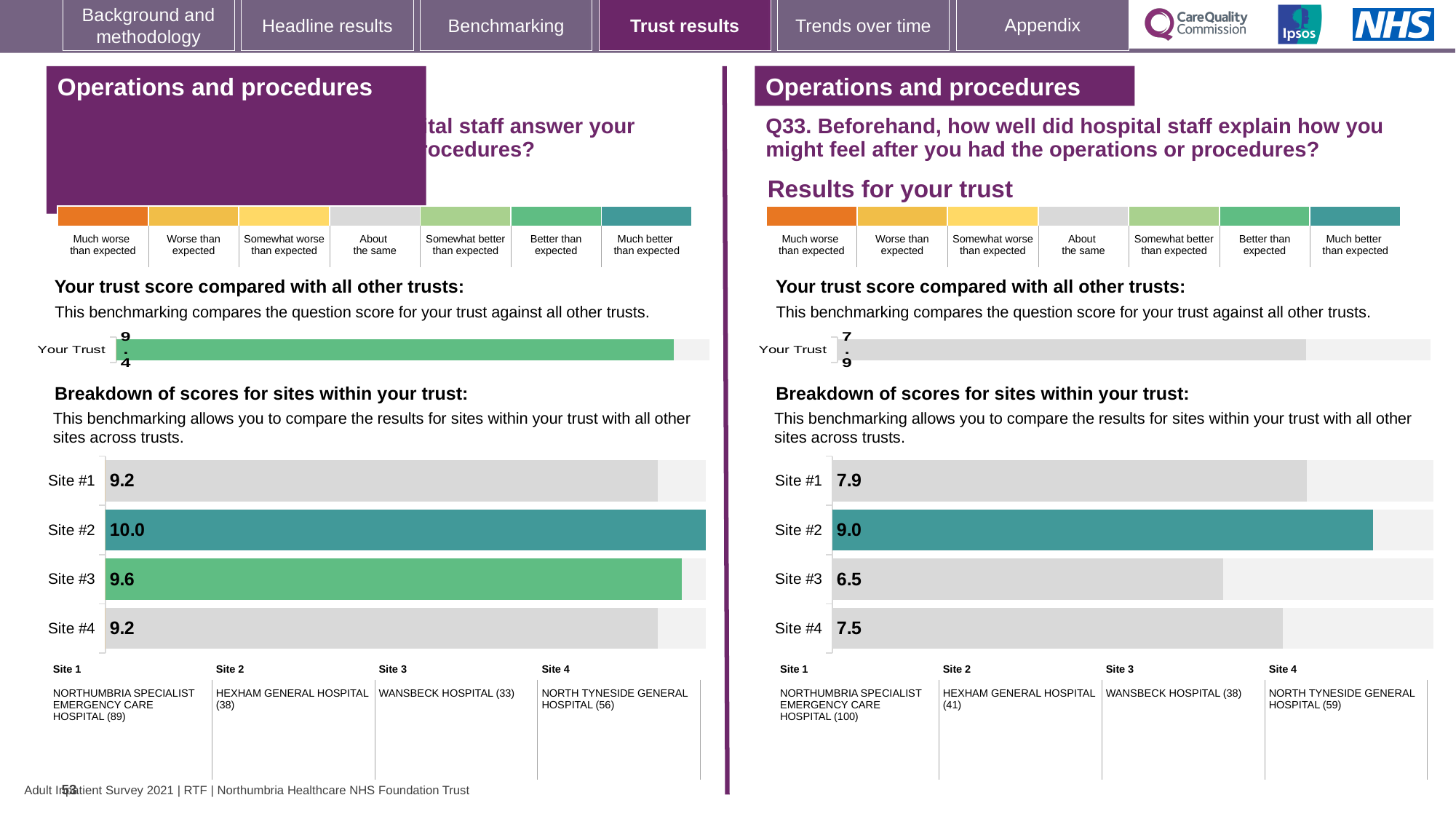
How many sites are shown on the left-hand site breakdown chart? 4 On the right-hand (Q33) site breakdown chart, which has the larger score, Site #1 or Site #4? Site #1 On the right-hand (Q33) site breakdown chart, what is the difference between the scores for Site #2 and Site #3? 2.5 On the left-hand site breakdown chart, what is the difference between the scores for Site #2 and Site #4? 0.8 On the left-hand site breakdown chart, what is the score for Site #3? 9.6 What is the 'Your Trust' score shown on the left-hand trust comparison chart? 9.4 On the left-hand site breakdown chart, which site has the highest score? Site #2 What type of chart is used for the site breakdown on the right-hand (Q33) side of the slide? Bar chart On the right-hand (Q33) site breakdown chart, what is the score for Site #2? 9.0 On the right-hand (Q33) site breakdown chart, which site's bar is coloured teal rather than grey? Site #2 On the right-hand (Q33) site breakdown chart, which site has the lowest score? Site #3 What is the 'Your Trust' score shown on the right-hand (Q33) trust comparison chart? 7.9